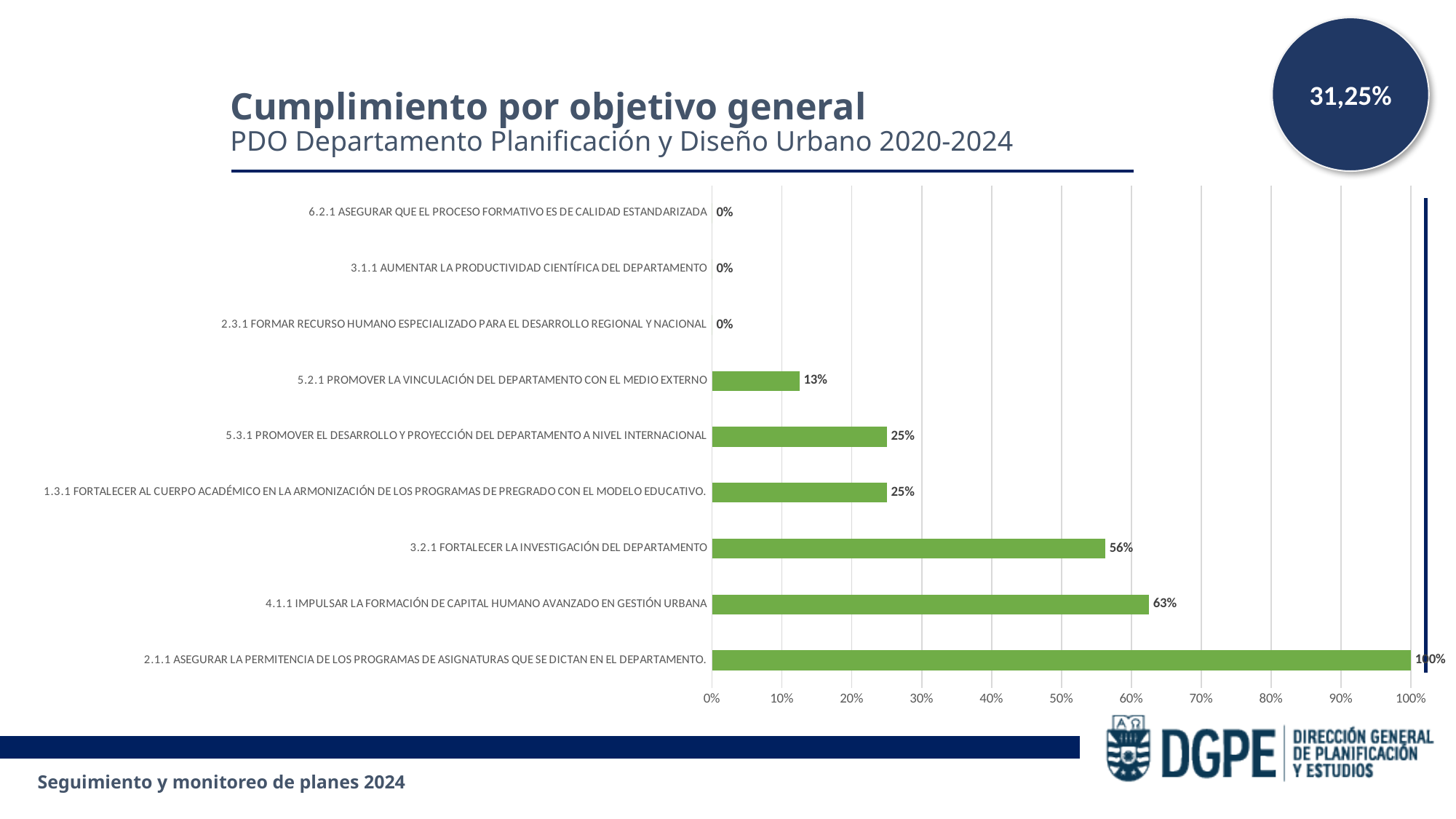
What is the value for 4.1.1 IMPULSAR LA FORMACIÓN DE CAPITAL HUMANO AVANZADO EN GESTIÓN URBANA? 63% What kind of chart is shown on the slide? bar chart How many categories are shown in the chart? 9 What is the value for 3.2.1 FORTALECER LA INVESTIGACIÓN DEL DEPARTAMENTO? 56% How many categories have a value of 0%? 3 What is the value for 2.1.1 ASEGURAR LA PERMITENCIA DE LOS PROGRAMAS DE ASIGNATURAS QUE SE DICTAN EN EL DEPARTAMENTO.? 100% What is the difference between the values for 4.1.1 IMPULSAR LA FORMACIÓN DE CAPITAL HUMANO AVANZADO EN GESTIÓN URBANA and 3.2.1 FORTALECER LA INVESTIGACIÓN DEL DEPARTAMENTO? 7% Which category has the highest value? 2.1.1 ASEGURAR LA PERMITENCIA DE LOS PROGRAMAS DE ASIGNATURAS QUE SE DICTAN EN EL DEPARTAMENTO. Is the value for 3.2.1 FORTALECER LA INVESTIGACIÓN DEL DEPARTAMENTO greater or less than 50%? greater What is the value for 5.2.1 PROMOVER LA VINCULACIÓN DEL DEPARTAMENTO CON EL MEDIO EXTERNO? 13% What is the title of the chart? Cumplimiento por objetivo general Which is larger: the value for 5.3.1 PROMOVER EL DESARROLLO Y PROYECCIÓN DEL DEPARTAMENTO A NIVEL INTERNACIONAL or the value for 5.2.1 PROMOVER LA VINCULACIÓN DEL DEPARTAMENTO CON EL MEDIO EXTERNO? 5.3.1 PROMOVER EL DESARROLLO Y PROYECCIÓN DEL DEPARTAMENTO A NIVEL INTERNACIONAL